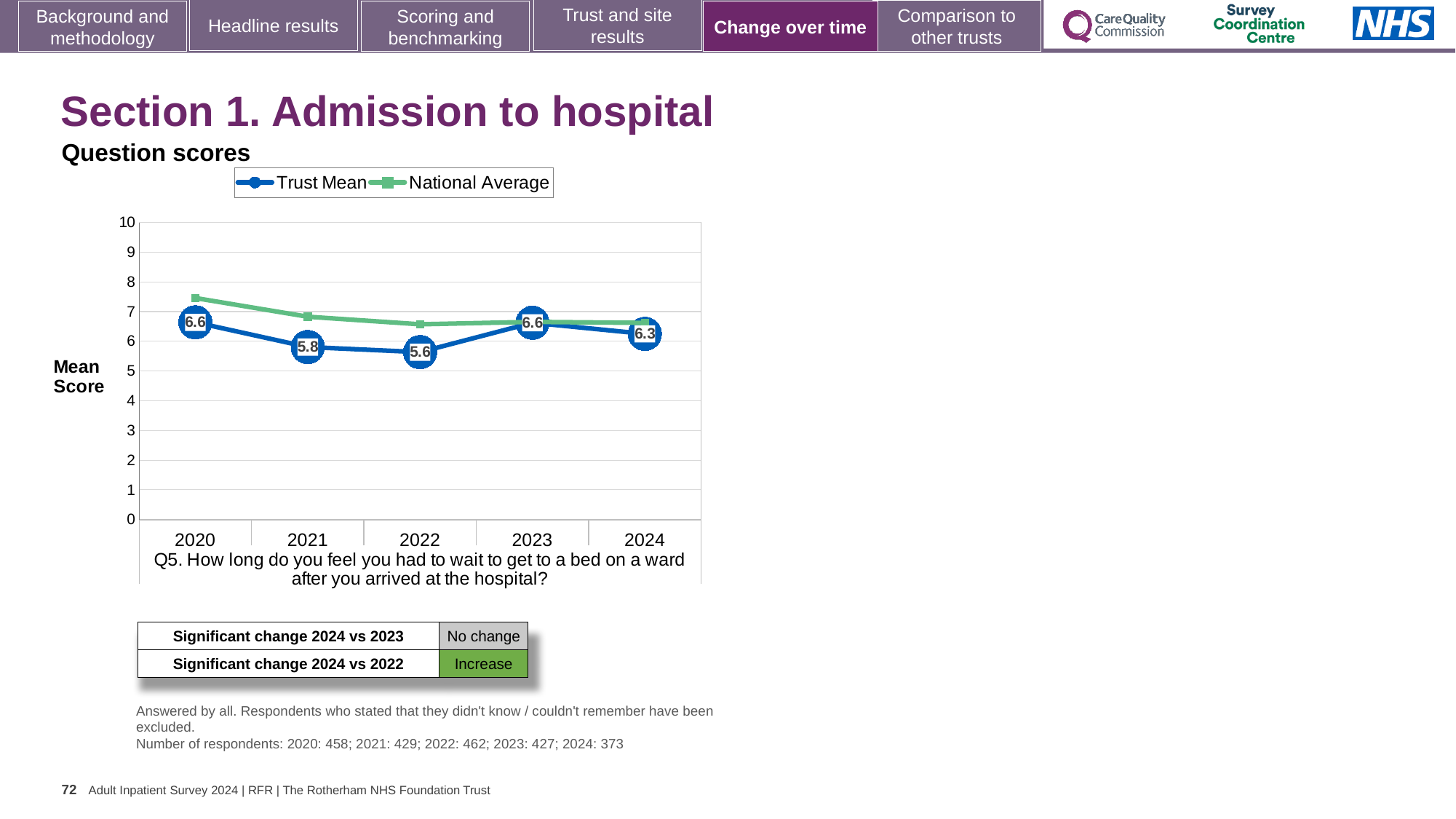
Which is larger, the Trust Mean score for 2021 or for 2024? 2024 What is the Trust Mean score for 2022? 5.6 How many years are plotted on the x axis? 5 Is the National Average value for 2022 greater or less than 7? less What is the Trust Mean score for 2024? 6.3 How many series does the legend list? 2 What is the Trust Mean score for 2021? 5.8 In which year is the Trust Mean score lowest? 2022 Is the National Average value for 2020 greater or less than 7? greater What is the difference between the Trust Mean scores for 2023 and 2022? 1.0 What kind of chart is shown? Line chart Does the Trust Mean score rise or fall from 2020 to 2022? Fall